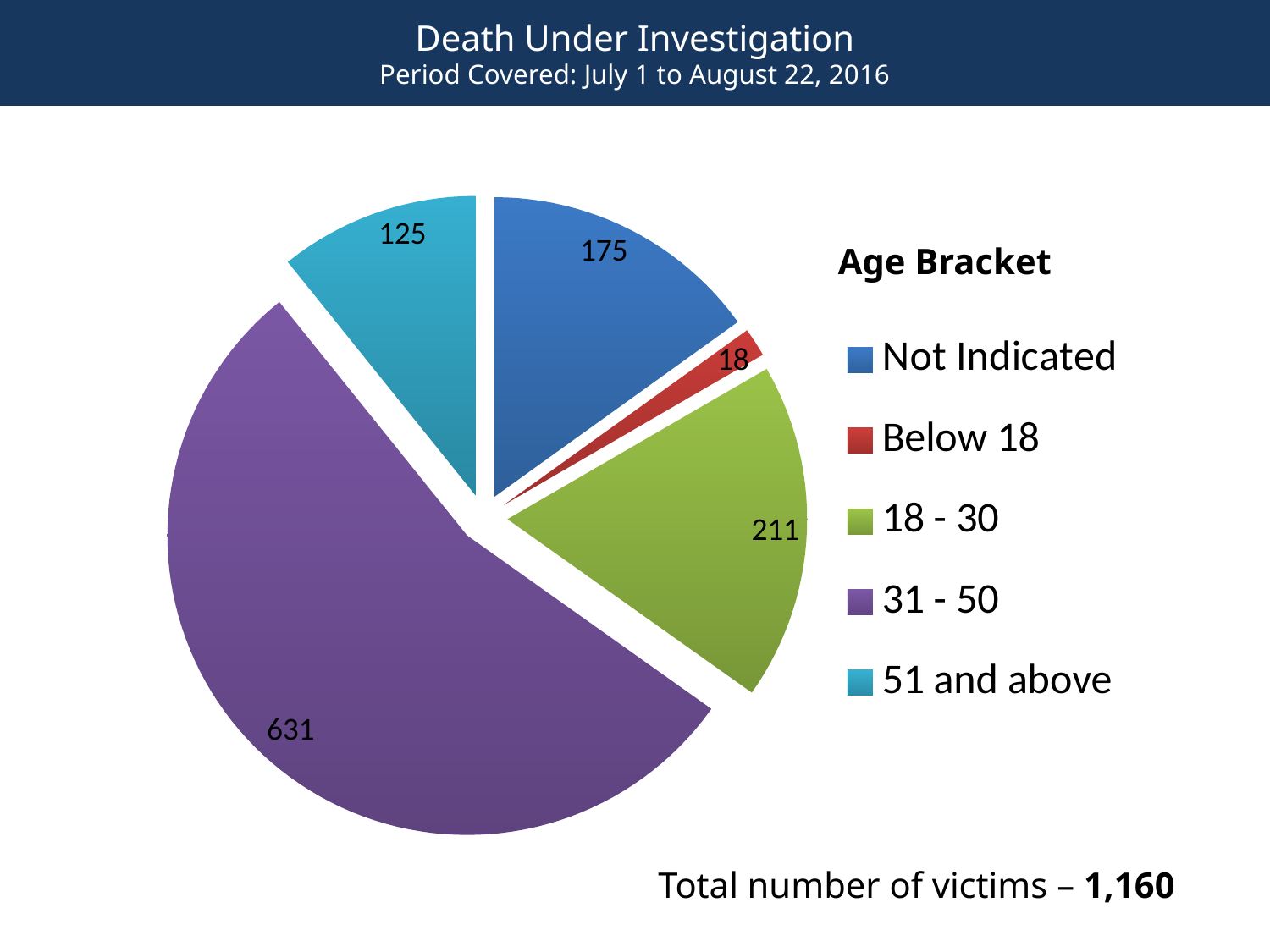
Which age bracket has the smallest number of victims? Below 18 How many victims are in the 31 - 50 age bracket? 631 What is the title of the legend on the slide? Age Bracket Which is larger, the Not Indicated slice or the 51 and above slice? Not Indicated What type of chart is shown on the slide? Pie chart How many age bracket categories does the pie chart show? 5 What is the value for the Not Indicated slice? 175 What share of the total number of victims does the 31 - 50 slice represent? 54.4% What is the value for the 51 and above slice? 125 Which age bracket has the largest number of victims? 31 - 50 What is the difference between the 31 - 50 and 18 - 30 values? 420 How many victims are in the 18 - 30 age bracket? 211